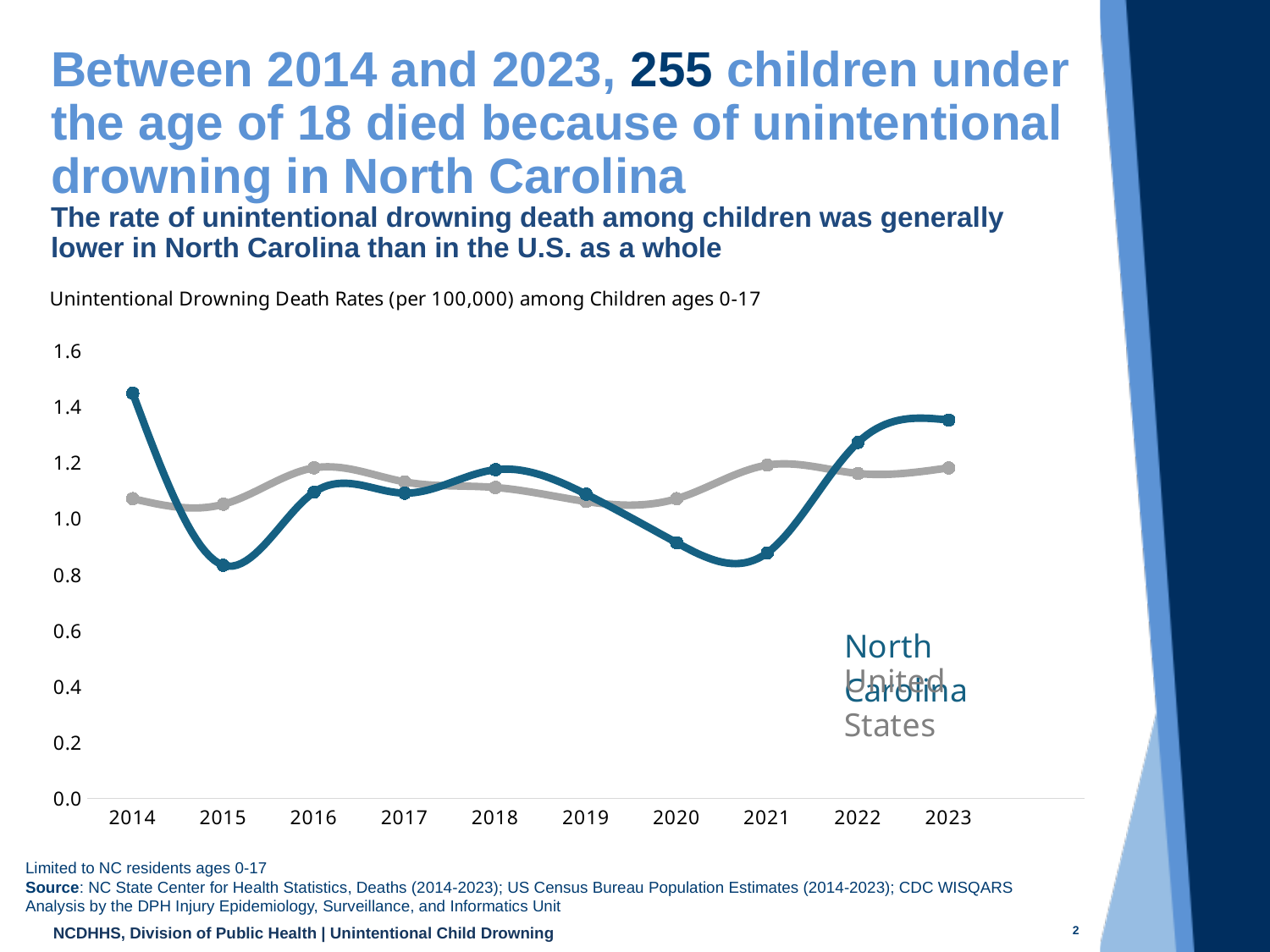
Does the North Carolina rate rise or fall between 2021 and 2023? rise In 2023, which series has the larger value, North Carolina or United States? North Carolina In which year was the North Carolina unintentional drowning death rate highest? 2014 Is the United States value for 2021 greater or less than 1.0? greater Is the North Carolina value for 2015 greater or less than 1.0? less Is the North Carolina value for 2014 greater or less than 1.4? greater What kind of chart is shown on the slide? Line chart In which year was the North Carolina unintentional drowning death rate lowest? 2015 In 2015, which series has the larger value, North Carolina or United States? United States What is the title of the chart? Unintentional Drowning Death Rates (per 100,000) among Children ages 0-17 How many years are plotted along the x axis of the chart? 10